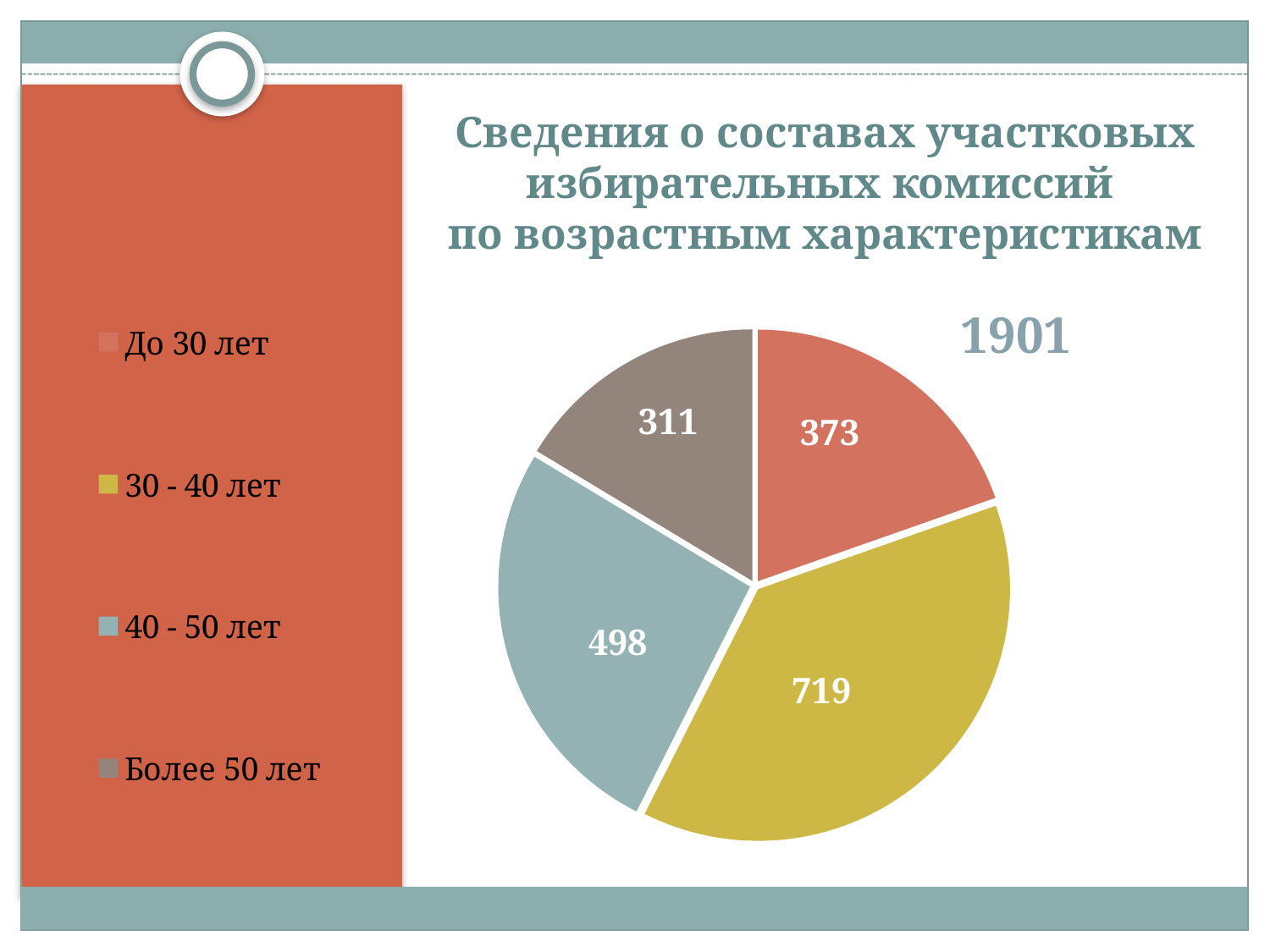
What is the value for the "Более 50 лет" slice? 311 What is the value for the "40 - 50 лет" slice? 498 What kind of chart is shown on the slide? Pie chart How many slices does the pie chart have? 4 What is the difference between the values for "30 - 40 лет" and "40 - 50 лет"? 221 What is the value for the "30 - 40 лет" slice? 719 Which is larger, the value for "До 30 лет" or the value for "Более 50 лет"? До 30 лет What total number is printed next to the pie chart? 1901 What is the value for the "До 30 лет" slice? 373 Which age group has the smallest slice of the pie? Более 50 лет What colour is the "40 - 50 лет" slice in the pie chart? Teal (blue-grey) Which age group has the largest slice of the pie? 30 - 40 лет